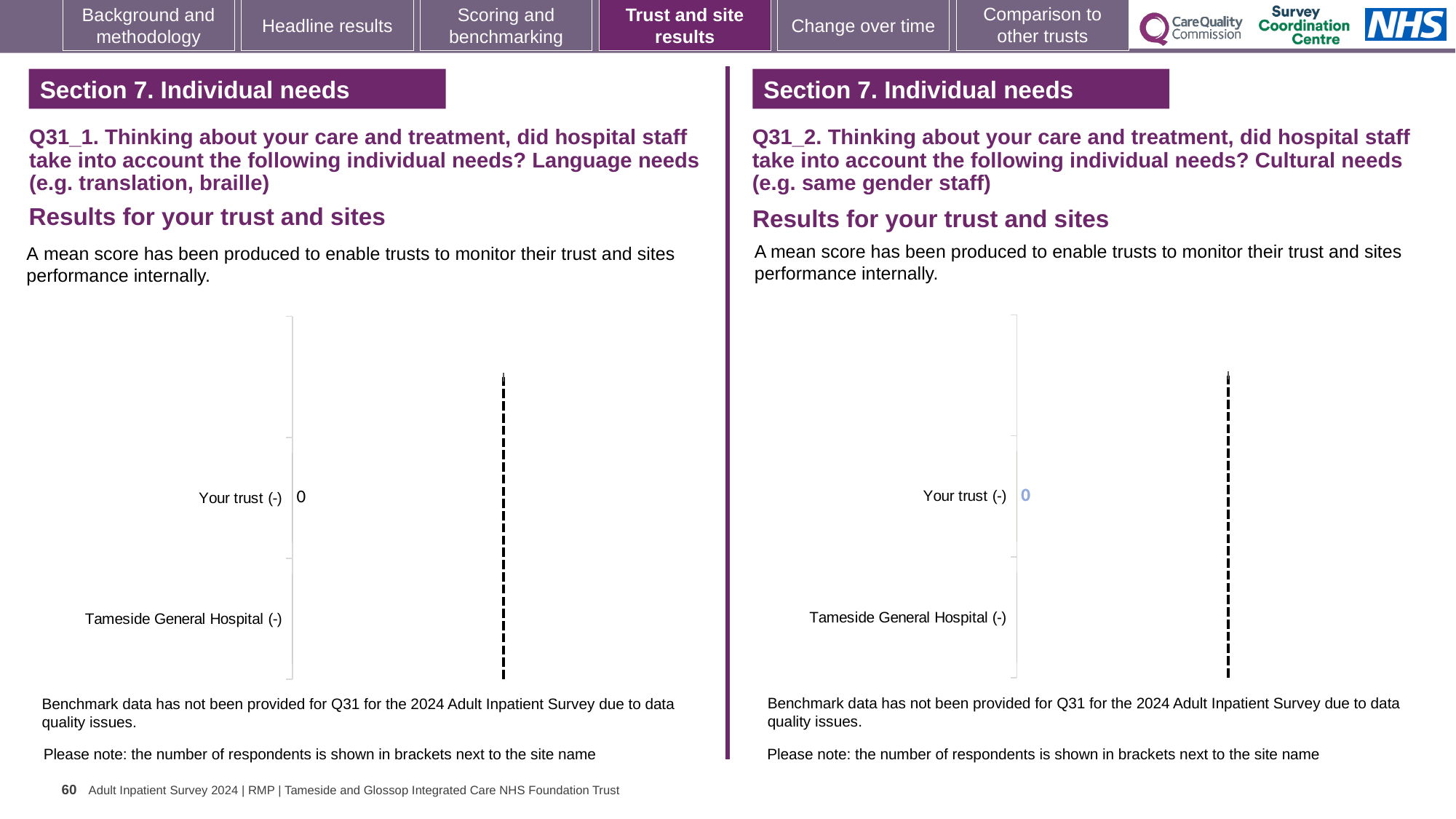
In the right chart (Q31_2, Cultural needs), what is shown in brackets next to the site name Tameside General Hospital? - How many categories are listed on the y axis of the right chart (Q31_2, Cultural needs)? 2 In the left chart (Q31_1, Language needs), what value is shown for Your trust? 0 How many categories are listed on the y axis of the left chart (Q31_1, Language needs)? 2 In the right chart (Q31_2, Cultural needs), what value is shown for Your trust? 0 In the left chart (Q31_1, Language needs), which category is listed below Your trust? Tameside General Hospital (-)